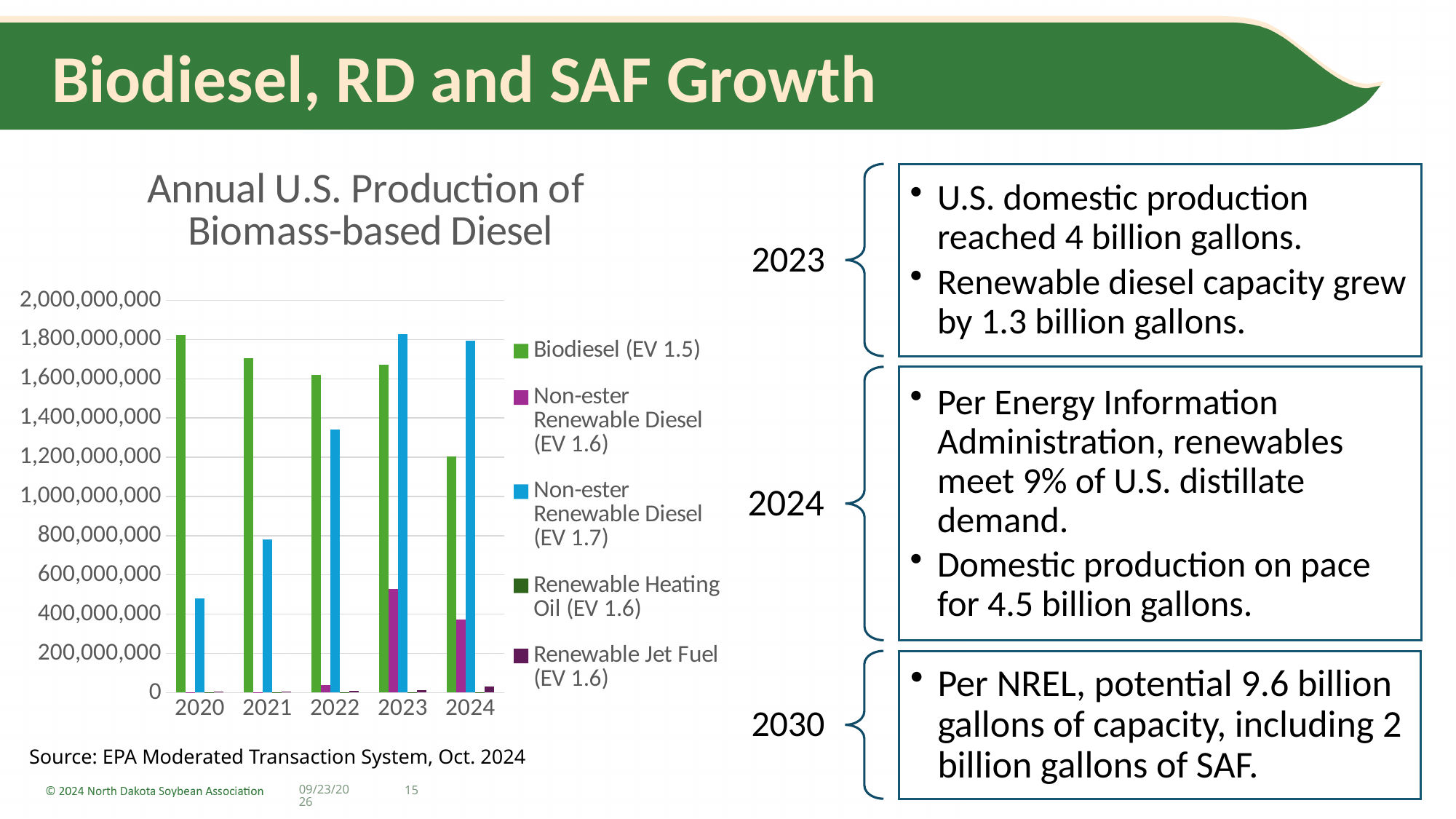
Is the value for Biodiesel (EV 1.5) in 2024 greater or less than 1,400,000,000? less What is the title of the chart? Annual U.S. Production of Biomass-based Diesel Does Non-ester Renewable Diesel (EV 1.7) production rise or fall from 2020 to 2023? Rise In which year is Biodiesel (EV 1.5) production lowest? 2024 How many years are shown on the x axis of the chart? 5 In which year is Non-ester Renewable Diesel (EV 1.7) production lowest? 2020 In 2023, which is larger: Biodiesel (EV 1.5) or Non-ester Renewable Diesel (EV 1.7)? Non-ester Renewable Diesel (EV 1.7) How many series does the chart's legend list? 5 What type of chart is shown on the slide? Bar chart Is the value for Non-ester Renewable Diesel (EV 1.7) in 2022 greater or less than 1,200,000,000? greater In 2022, which is larger: Biodiesel (EV 1.5) or Non-ester Renewable Diesel (EV 1.7)? Biodiesel (EV 1.5) In which year is Biodiesel (EV 1.5) production highest? 2020